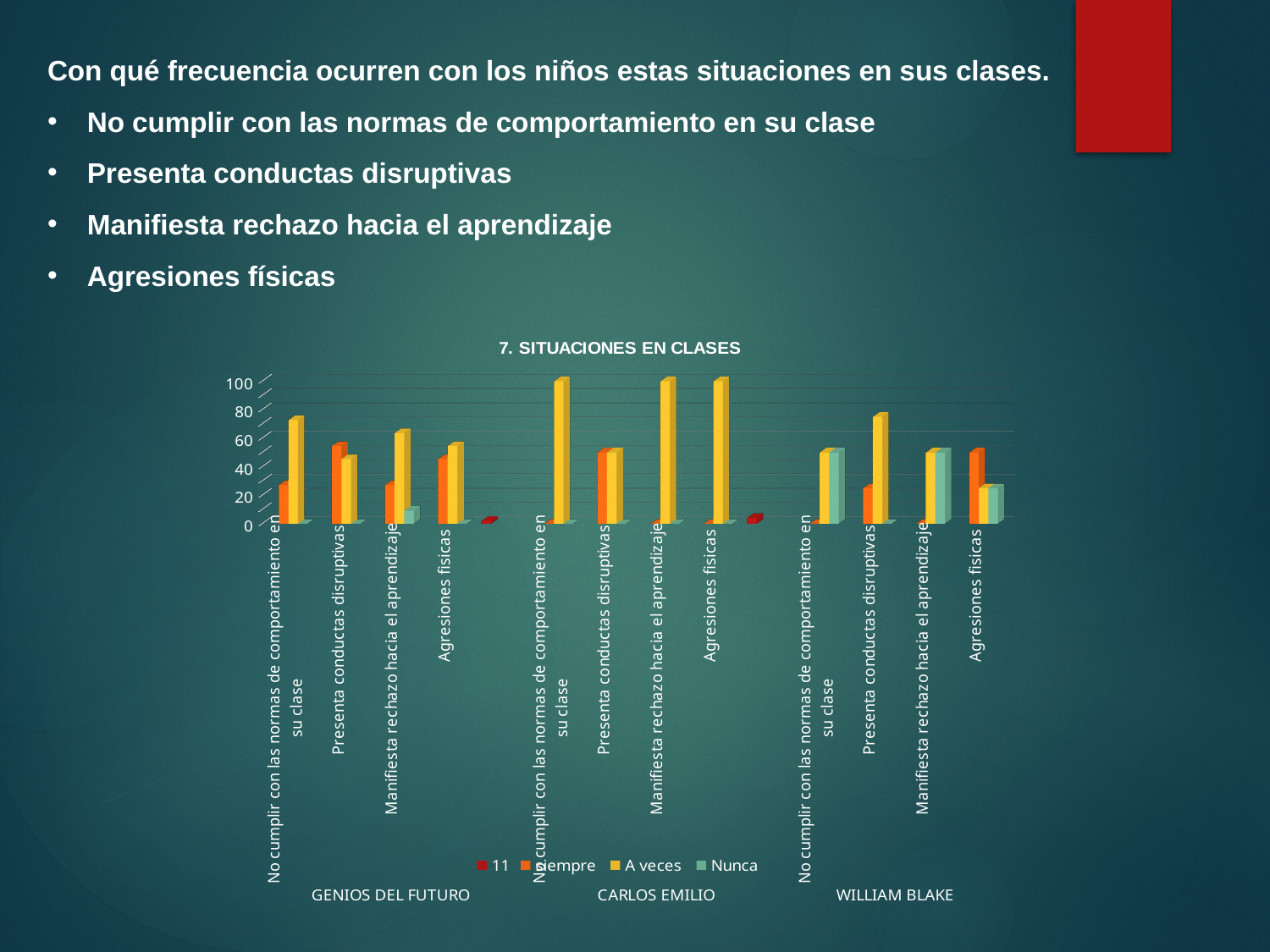
For 'Manifiesta rechazo hacia el aprendizaje' under GENIOS DEL FUTURO, which is larger: 'Siempre' or 'A veces'? A veces How many situation categories are plotted for each school group? 4 Is the 'A veces' value for 'No cumplir con las normas de comportamiento en su clase' under CARLOS EMILIO greater or less than 80? greater Is the 'Nunca' value for 'Manifiesta rechazo hacia el aprendizaje' under GENIOS DEL FUTURO greater or less than 20? less How many school groups are labelled along the bottom of the chart? 3 How many series does the chart legend list? 4 Is the 'A veces' value for 'No cumplir con las normas de comportamiento en su clase' under GENIOS DEL FUTURO greater or less than 60? greater For 'Agresiones físicas' under WILLIAM BLAKE, which is larger: 'Siempre' or 'Nunca'? Siempre What is the title of the chart? 7. SITUACIONES EN CLASES What are the entries in the chart legend? 11, siempre, A veces, Nunca What kind of chart is shown on the slide? bar chart